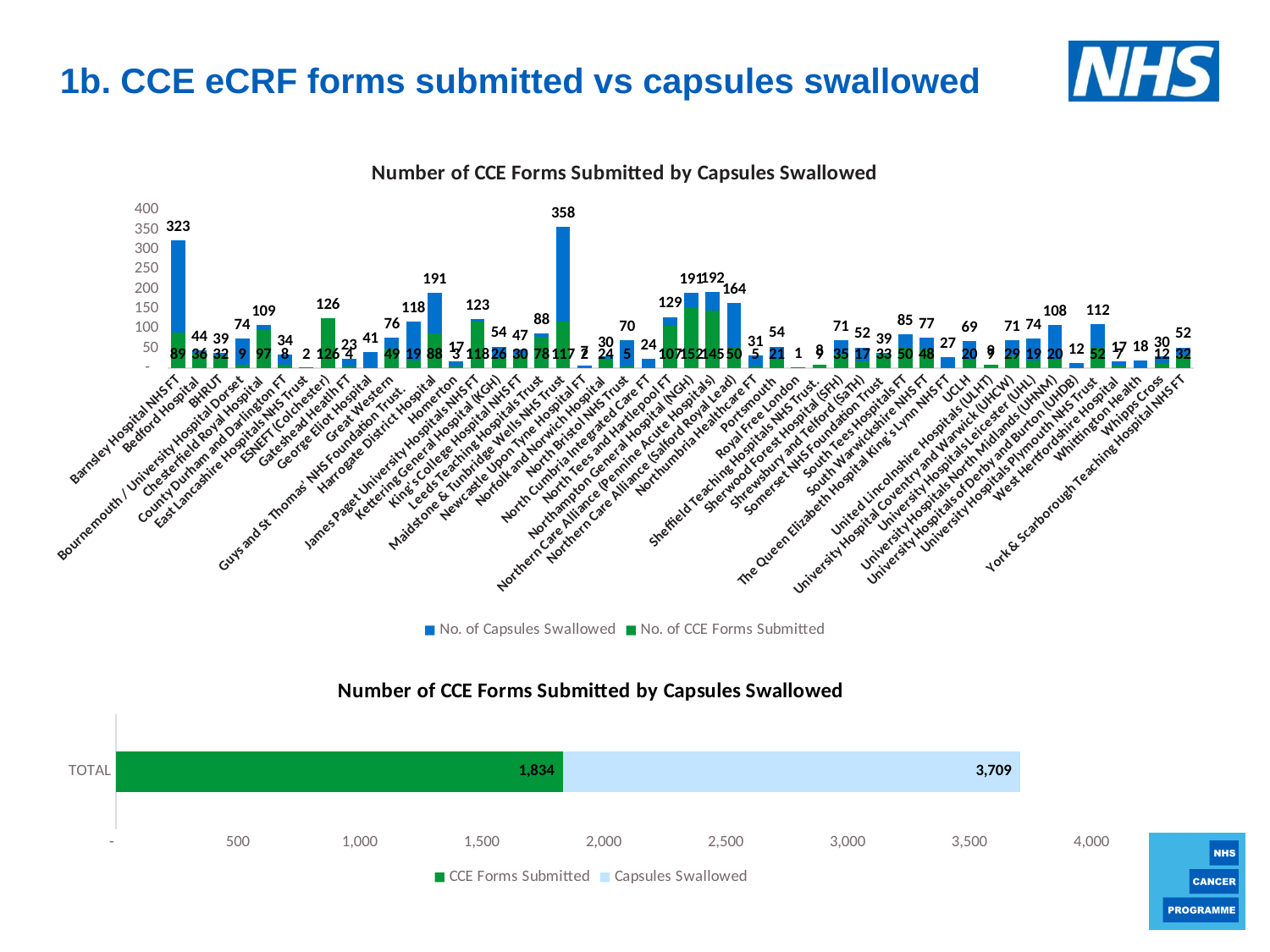
In the bottom chart, how many series does the legend list? 2 In the bottom chart, what is the total length of the TOTAL stacked bar? 3,709 In the bottom chart, which is larger, CCE Forms Submitted or Capsules Swallowed? Capsules Swallowed In the top chart, what is the number of CCE forms submitted for Barnsley Hospital NHS FT? 89 In the bottom chart, is the value for Capsules Swallowed greater or less than 3,500? greater In the top chart, which hospital has the highest number of capsules swallowed? Maidstone & Tunbridge Wells NHS Trust In the top chart, which series is shown in blue? No. of Capsules Swallowed In the top chart, what is the number of capsules swallowed for Barnsley Hospital NHS FT? 323 In the bottom chart, what is the value for CCE Forms Submitted? 1,834 What kind of chart is the top chart? Bar chart In the bottom chart, what is the value for Capsules Swallowed? 3,709 In the bottom chart, what is the difference between Capsules Swallowed and CCE Forms Submitted? 1,875